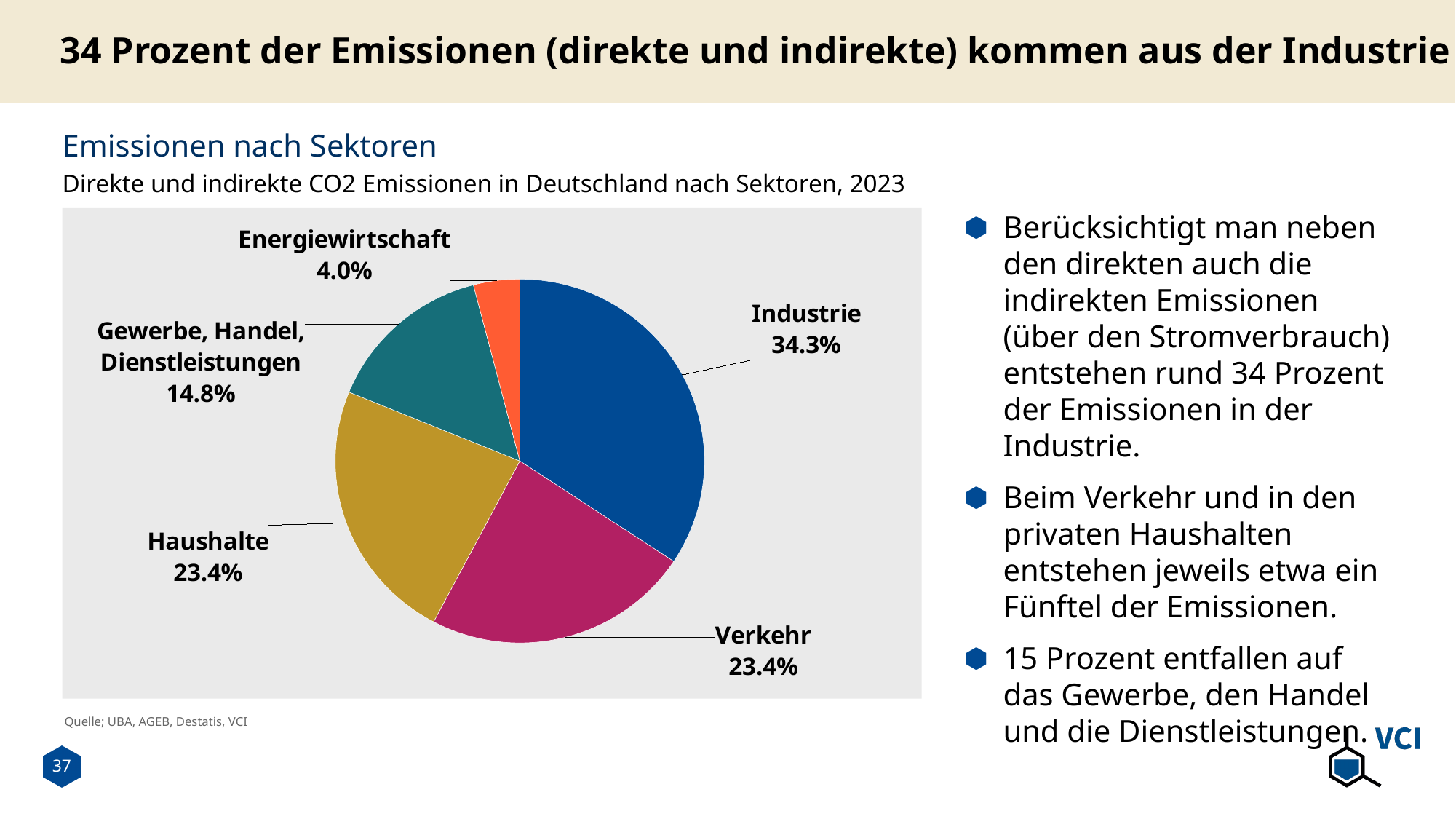
What is the combined share of Haushalte and Verkehr? 46.8% Which sector has the smallest share of emissions? Energiewirtschaft Which is larger, the share for Gewerbe, Handel, Dienstleistungen or the share for Energiewirtschaft? Gewerbe, Handel, Dienstleistungen How many sectors are shown in the pie chart? 5 What is the difference in percentage points between Industrie and Verkehr? 10.9 What share of emissions comes from Gewerbe, Handel, Dienstleistungen? 14.8% What share of emissions comes from Industrie? 34.3% What is the title of the chart? Emissionen nach Sektoren What share of emissions comes from Haushalte? 23.4% Which sector has the largest share of emissions? Industrie What type of chart is shown on the slide? Pie chart What share of emissions comes from Energiewirtschaft? 4.0%